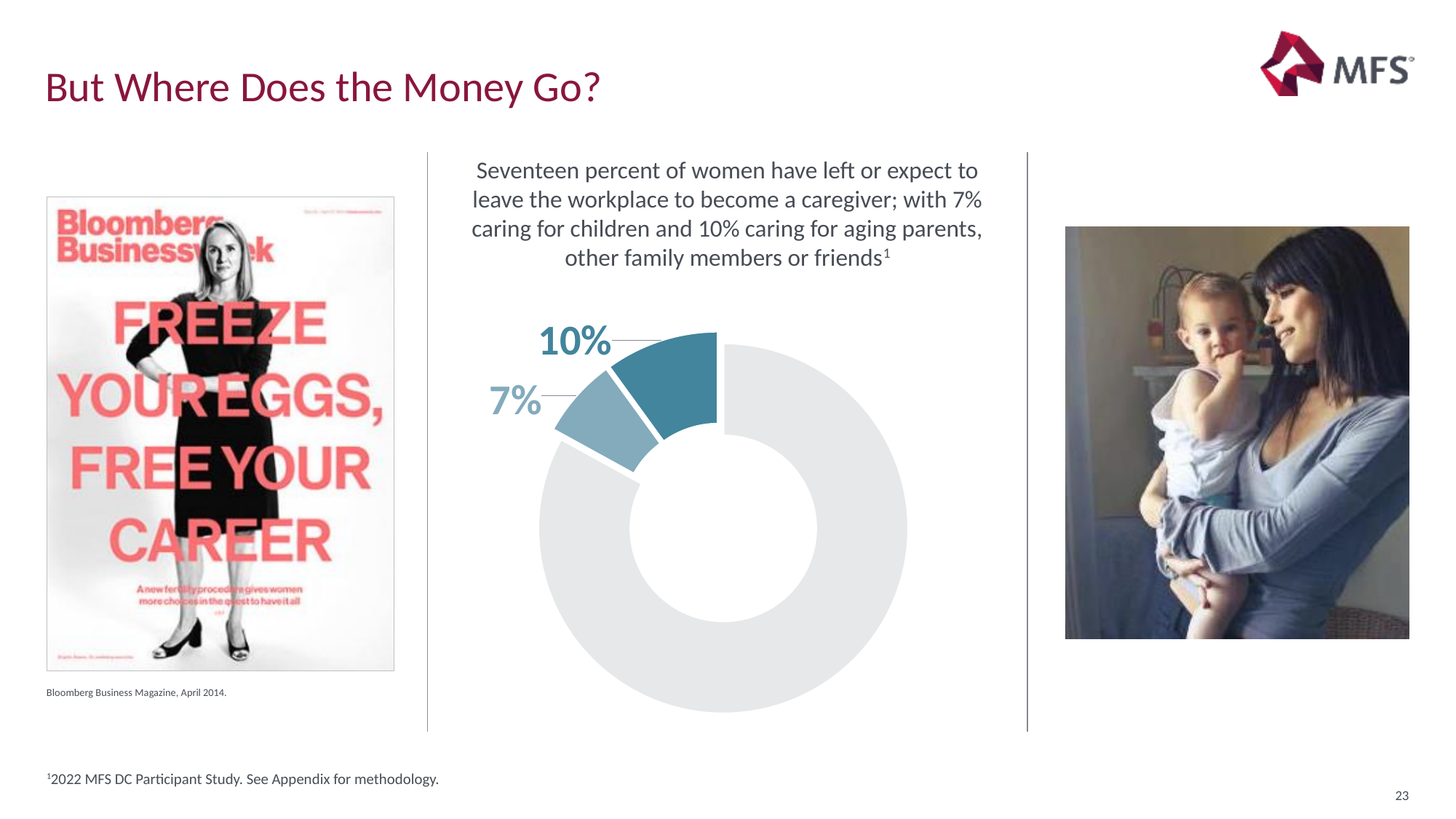
According to the slide, what share of women left or expect to leave the workplace to care for children? 7% How many slices in the donut chart have a percentage label? 2 What kind of chart is shown in the middle of the slide? donut chart What is the title of the slide containing the donut chart? But Where Does the Money Go? What value is labelled on the light blue slice of the donut chart? 7% Which of the two labelled slices in the donut chart is larger, 10% or 7%? 10% What value is labelled on the dark blue slice of the donut chart? 10% What colour is the largest, unlabelled portion of the donut chart? grey What is the difference between the two labelled slices in the donut chart? 3% Is the unlabelled grey portion of the donut chart larger or smaller than the two labelled slices combined? larger What do the two labelled slices of the donut chart add up to? 17% According to the slide, what share of women left or expect to leave the workplace to care for aging parents, other family members or friends? 10%